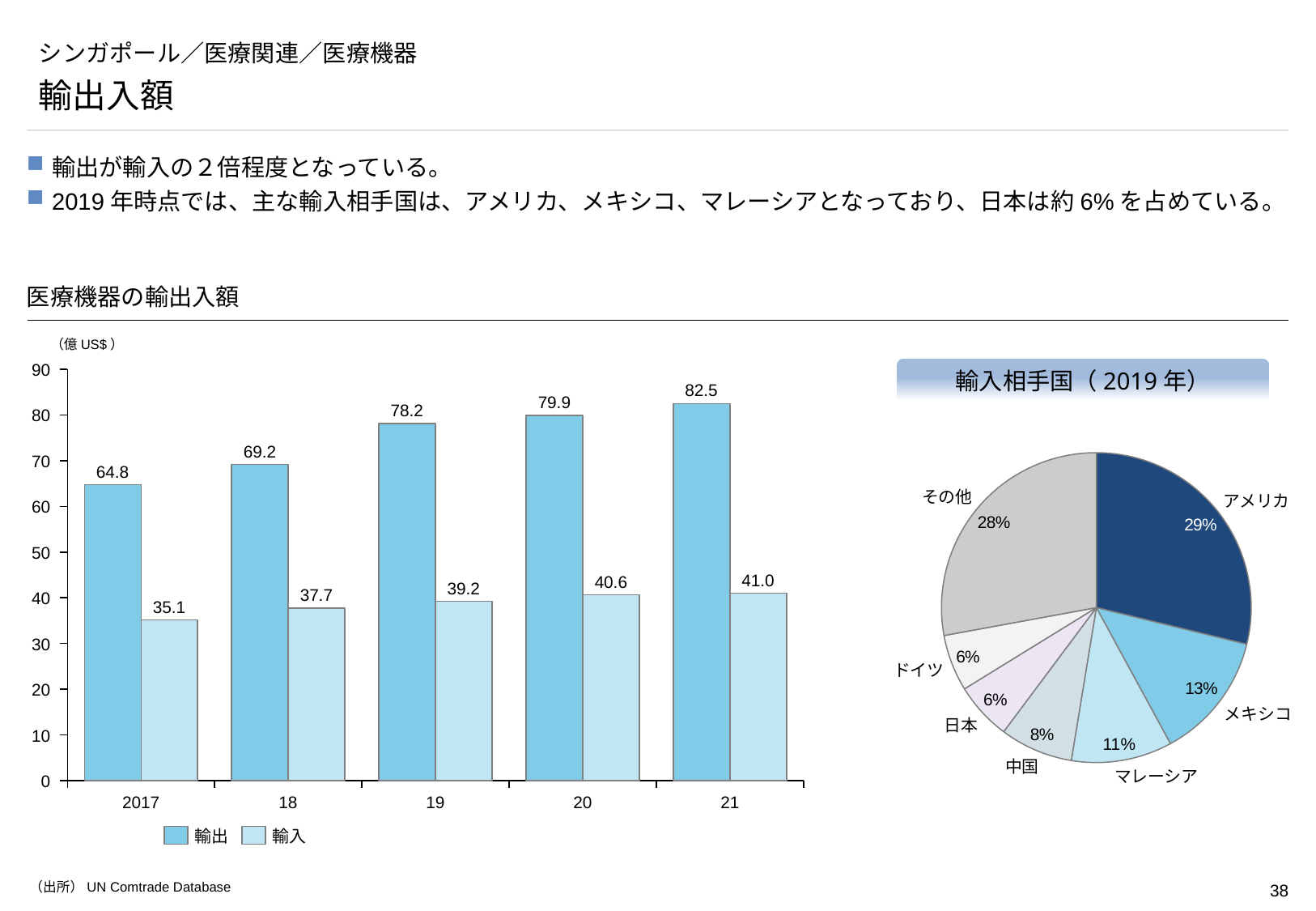
In the bar chart 医療機器の輸出入額, how many series does the legend list? 2 In the bar chart 医療機器の輸出入額, what is the value of 輸出 for 2017? 64.8 What kind of chart is the chart on the right of the slide? pie chart In the pie chart 輸入相手国（2019年）, what share does 日本 have? 6% In the bar chart 医療機器の輸出入額, do the 輸出 values rise or fall from 2017 to 21? rise In the bar chart 医療機器の輸出入額, which year has the lowest 輸入 value? 2017 In the bar chart 医療機器の輸出入額, which year has the highest 輸出 value? 21 In the pie chart 輸入相手国（2019年）, what share does アメリカ have? 29% In the bar chart 医療機器の輸出入額, what is the difference between 輸出 and 輸入 in 19? 39.0 In the pie chart 輸入相手国（2019年）, which named country has the largest share? アメリカ In the bar chart 医療機器の輸出入額, what is the value of 輸入 for 21? 41.0 In the bar chart 医療機器の輸出入額, how many years are shown on the x axis? 5